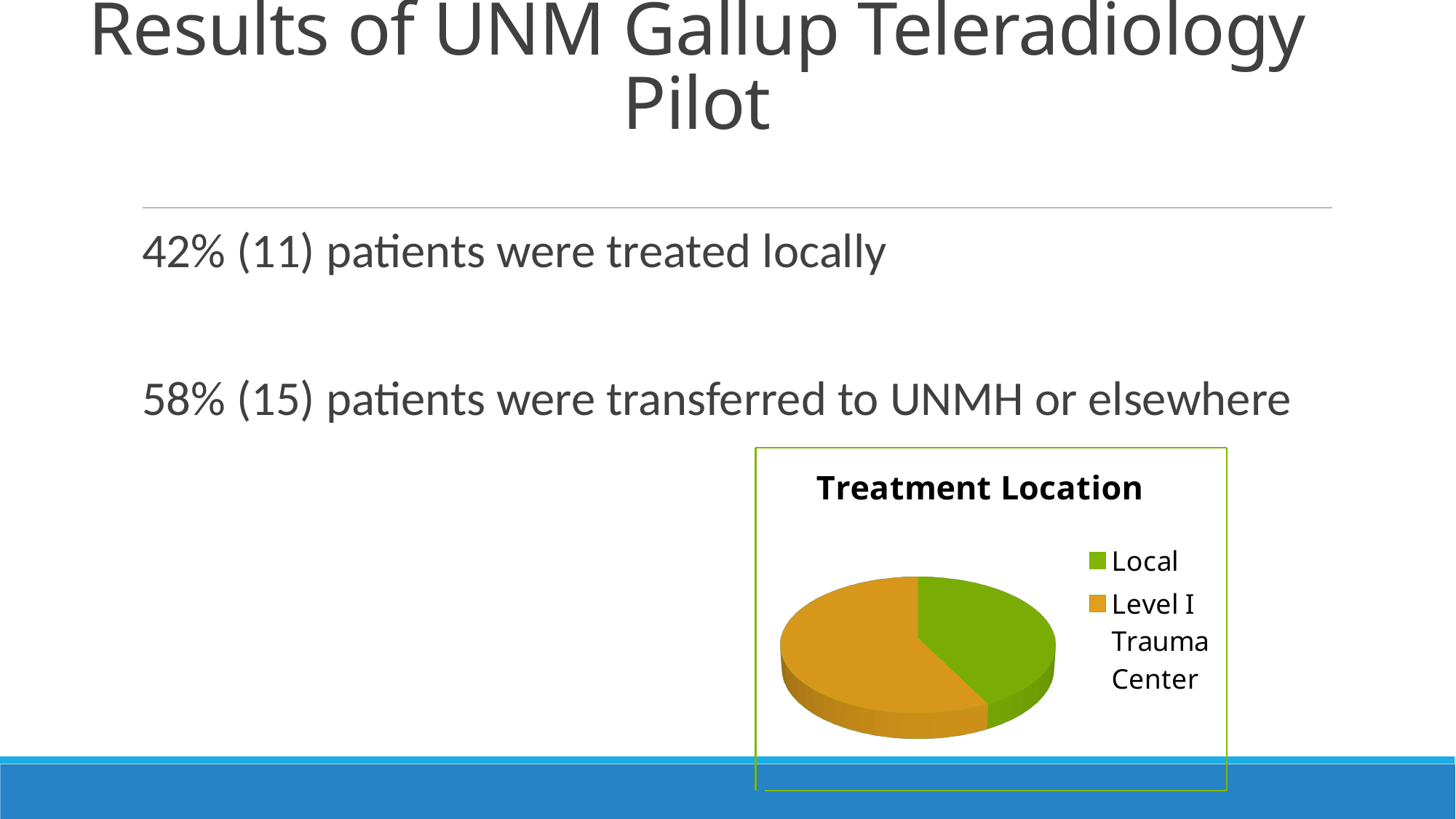
How many entries does the legend of the Treatment Location chart list? 2 How many slices does the Treatment Location pie chart have? 2 According to the slide, what share of patients does the Local slice of the Treatment Location chart represent? 42% What kind of chart is shown on the slide? pie chart What colour is the Local slice in the Treatment Location pie chart? green In the Treatment Location chart, which is larger: the Local slice or the Level I Trauma Center slice? Level I Trauma Center Which slice of the Treatment Location pie chart is the smallest? Local What is the title of the chart? Treatment Location Is the Local slice of the Treatment Location pie chart greater or less than half of the pie? less Which slice of the Treatment Location pie chart is the largest? Level I Trauma Center